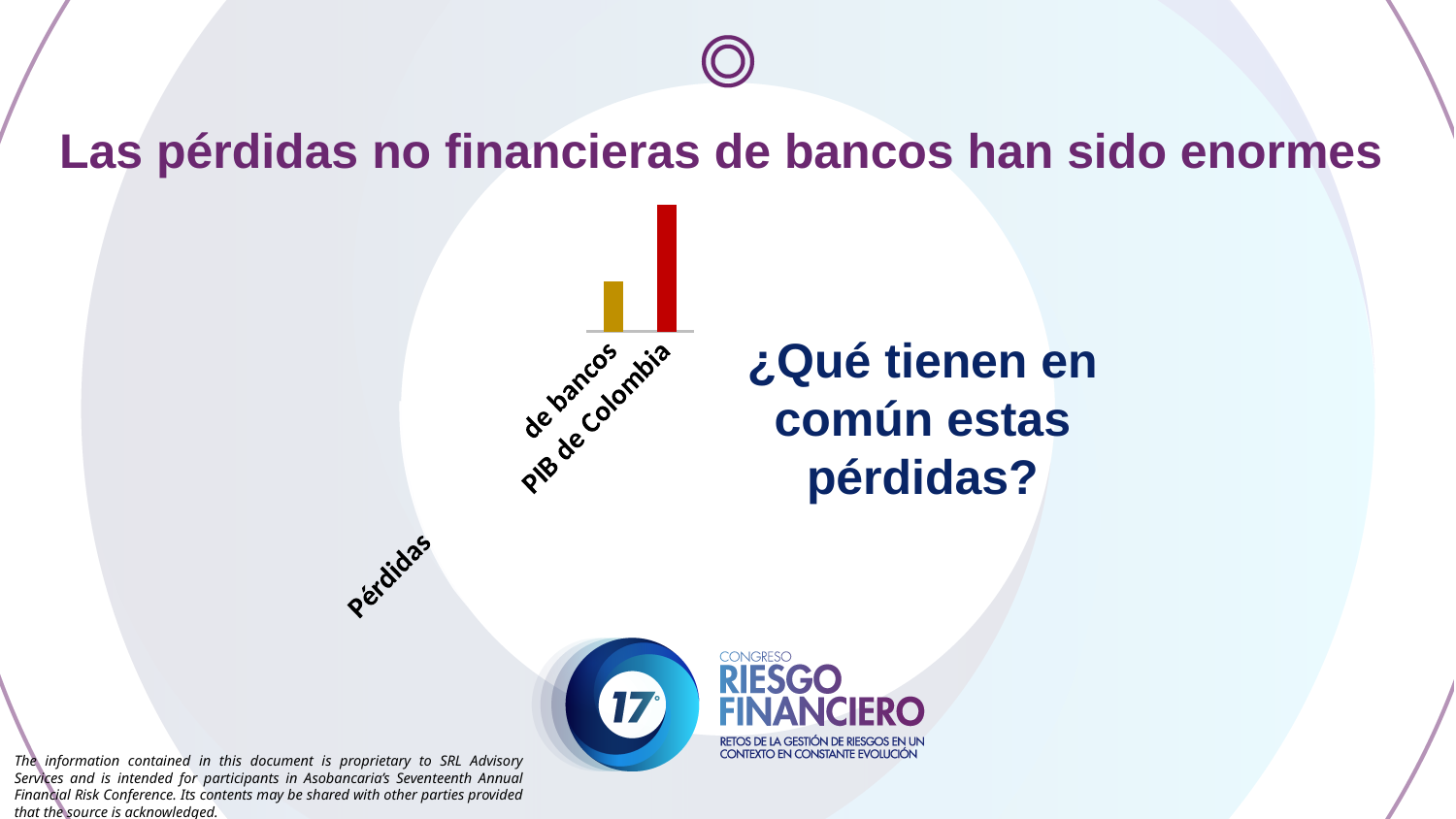
Which category has the lowest bar in the chart? Pérdidas de bancos How many bars does the chart show? 2 What kind of chart is shown on the slide? bar chart What colour is the bar for "PIB de Colombia"? red Which category has the highest bar in the chart? PIB de Colombia Which bar is taller, "Pérdidas de bancos" or "PIB de Colombia"? PIB de Colombia What colour is the bar for "Pérdidas de bancos"? gold